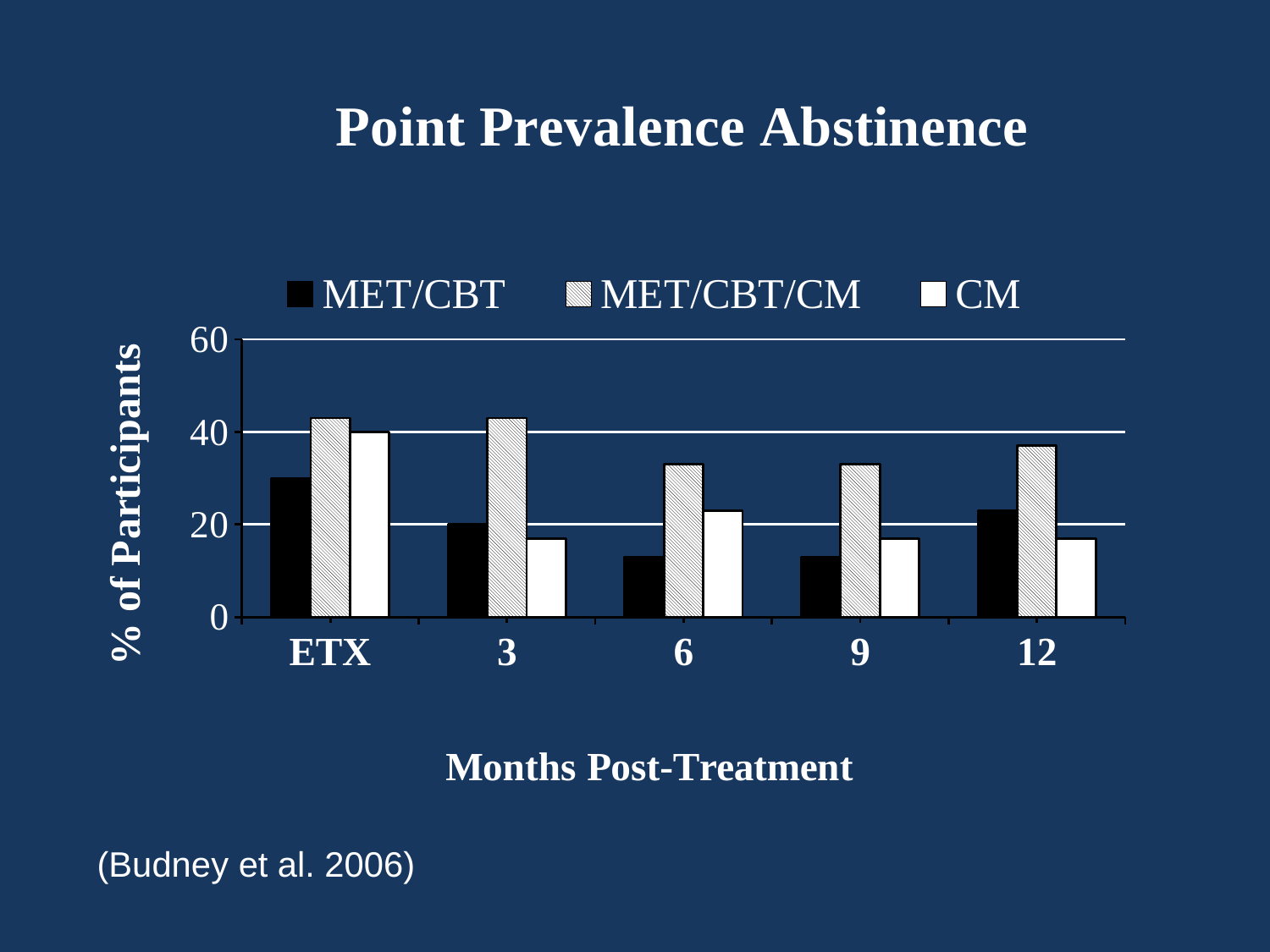
Is the value for MET/CBT at ETX greater or less than 20? greater Which series has the lowest value at ETX? MET/CBT How many time points are shown along the x axis? 5 Is the value for CM at 3 months greater or less than 20? less Does the MET/CBT series rise or fall from ETX to 6 months post-treatment? fall What kind of chart is shown on the slide? bar chart At 12 months post-treatment, which is larger: MET/CBT or CM? MET/CBT What is the title of the chart? Point Prevalence Abstinence Is the value for MET/CBT/CM at 12 months greater or less than 20? greater Which series has the highest value at 6 months post-treatment? MET/CBT/CM How many series does the legend list? 3